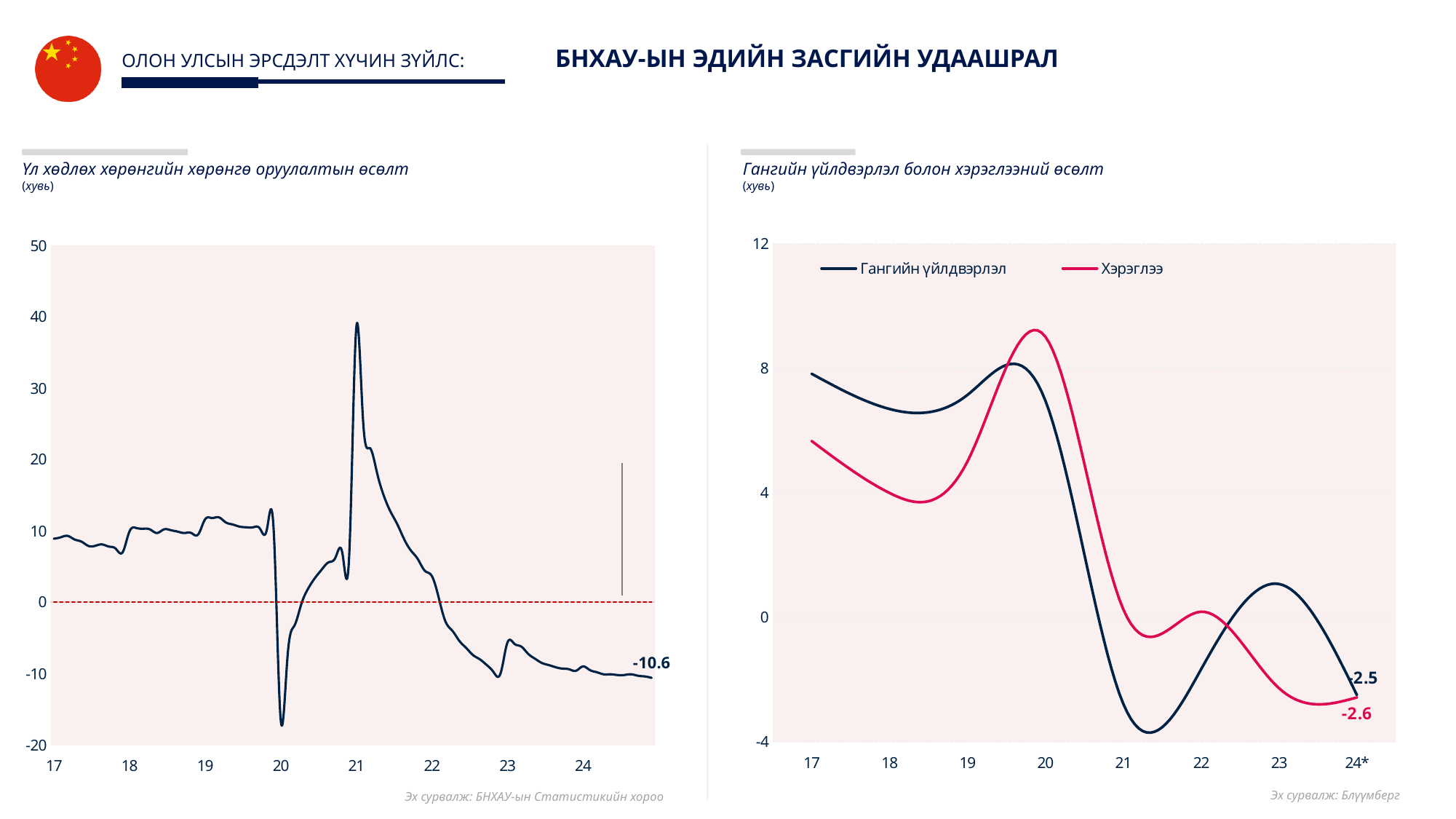
On the right chart, is the value of Хэрэглээ at 20 greater or less than 8? greater What kind of chart is the left chart (Үл хөдлөх хөрөнгийн хөрөнгө оруулалтын өсөлт)? Line chart On the right chart, what is the difference between the labelled 24* values for Гангийн үйлдвэрлэл (-2.5) and Хэрэглээ (-2.6)? 0.1 On the right chart (Гангийн үйлдвэрлэл болон хэрэглээний өсөлт), what is the value labelled for Гангийн үйлдвэрлэл at 24*? -2.5 On the left chart, is the peak value reached around 21 greater or less than 30? greater On the right chart, does the Гангийн үйлдвэрлэл line rise or fall between 23 and 24*? Fall How many year labels are shown on the x axis of the right chart? 8 On the right chart, which series has the higher labelled value at 24*: Гангийн үйлдвэрлэл or Хэрэглээ? Гангийн үйлдвэрлэл On the left chart, is the lowest value reached around 20 greater or less than -10? less How many series does the legend of the right chart list? 2 On the right chart (Гангийн үйлдвэрлэл болон хэрэглээний өсөлт), what is the value labelled for Хэрэглээ at 24*? -2.6 On the left chart (Үл хөдлөх хөрөнгийн хөрөнгө оруулалтын өсөлт), what is the value shown by the data label at the end of the line? -10.6